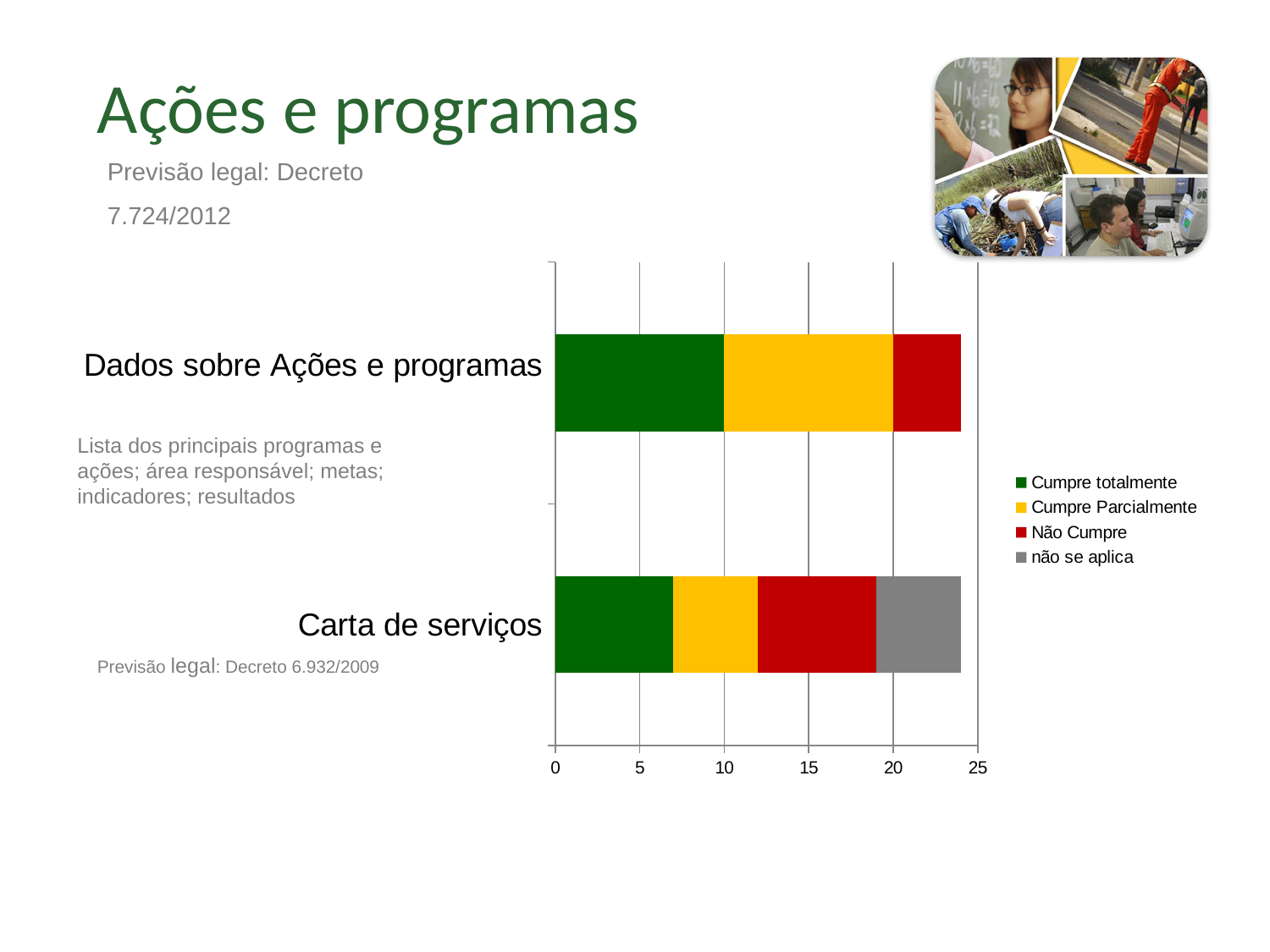
What kind of chart is shown on the slide? Stacked bar chart What is the value of 'Cumpre totalmente' for 'Dados sobre Ações e programas'? 10 Which category has the larger 'Cumpre Parcialmente' value, 'Dados sobre Ações e programas' or 'Carta de serviços'? Dados sobre Ações e programas Is the 'Cumpre totalmente' value for 'Dados sobre Ações e programas' greater or less than 5? greater Which category has the larger 'Não Cumpre' value, 'Dados sobre Ações e programas' or 'Carta de serviços'? Carta de serviços Is the 'Cumpre totalmente' value for 'Carta de serviços' greater or less than 10? less Which colour represents 'Não Cumpre' in the legend? Red How many categories are plotted on the chart? 2 How many series does the chart legend list? 4 Is the total length of the 'Dados sobre Ações e programas' bar greater or less than 20? greater Which category has the larger 'Cumpre totalmente' value, 'Dados sobre Ações e programas' or 'Carta de serviços'? Dados sobre Ações e programas